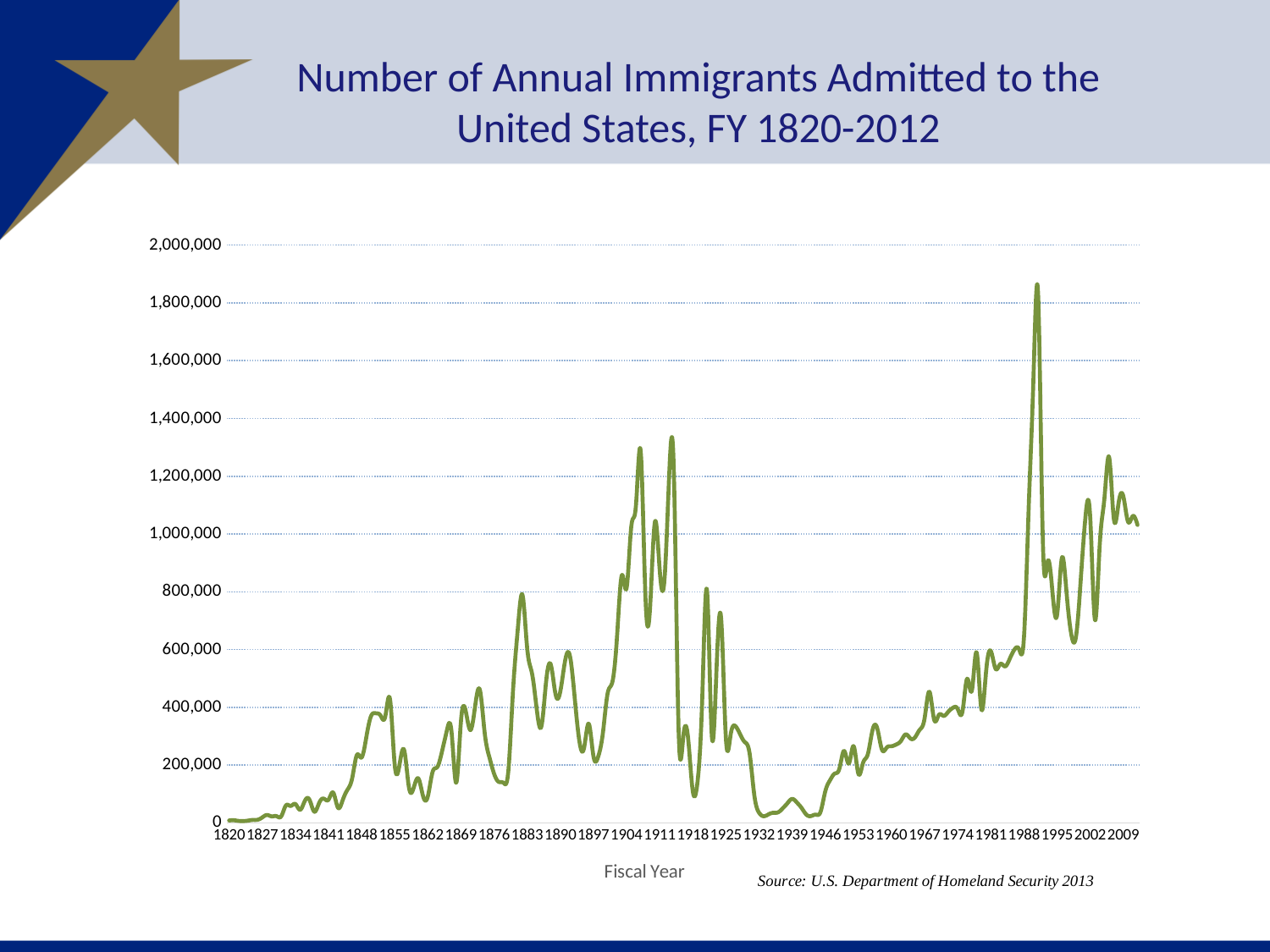
Is the highest value on the chart greater or less than 1,800,000? greater Is the value for 1967 greater or less than 600,000? less Is the value for 1904 greater or less than 600,000? greater What is the title of the chart? Number of Annual Immigrants Admitted to the United States, FY 1820-2012 Do the values generally rise or fall between 1820 and 1855? rise Do the values generally rise or fall between 1925 and 1932? fall What is the label of the x axis? Fiscal Year What kind of chart is shown on the slide? line chart